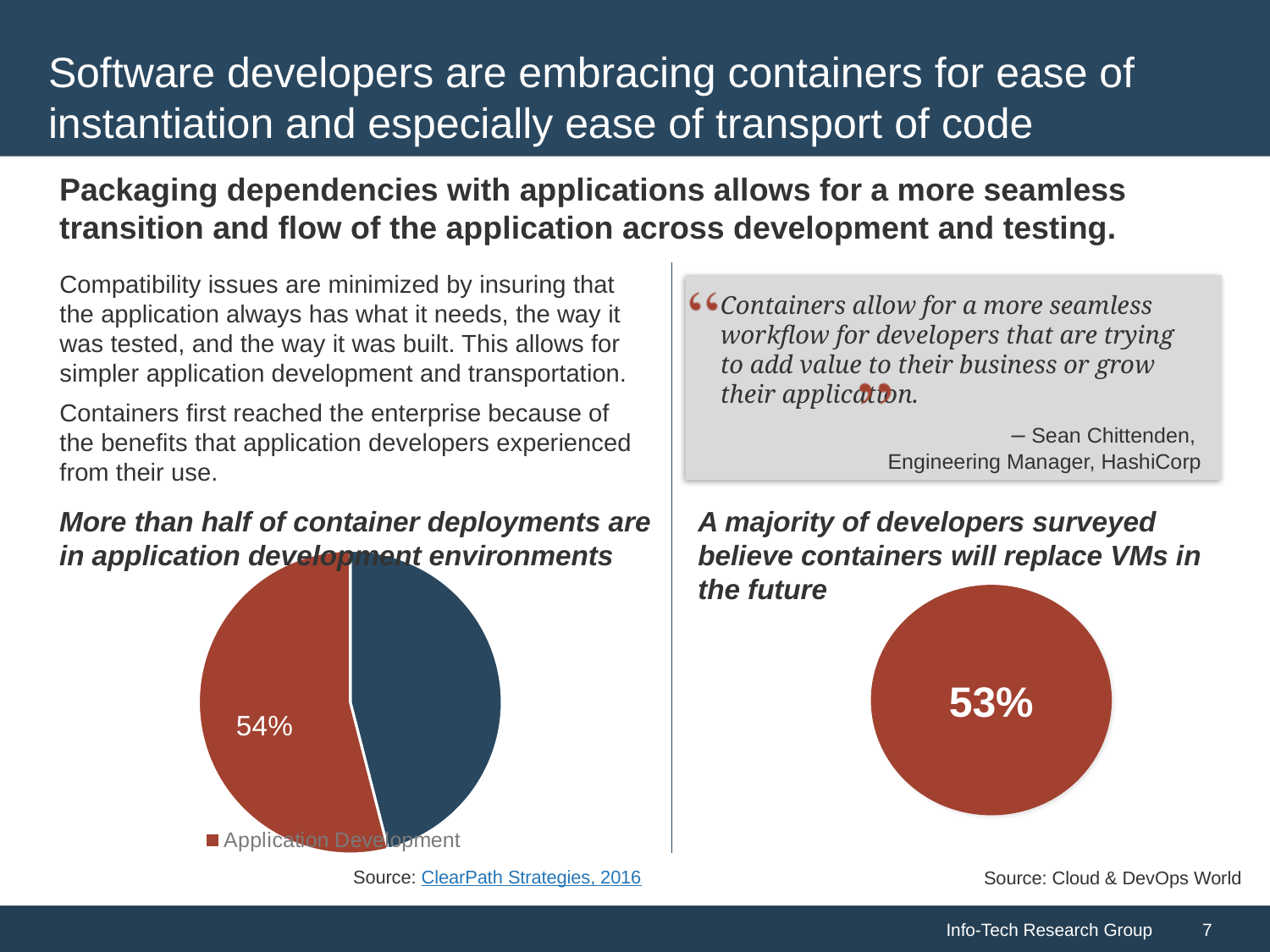
What kind of chart is shown on the left side of the slide under the heading about container deployments? pie chart What source is cited below the left pie chart? ClearPath Strategies, 2016 In the right-hand figure, what percentage of developers surveyed believe containers will replace VMs in the future? 53% How many slices does the left pie chart have? 2 What colour is the Application Development slice in the left pie chart? red In the left pie chart, which slice is larger, the red Application Development slice or the blue slice? Application Development In the left pie chart, what percentage is shown for Application Development? 54% How many entries does the legend of the left pie chart list? 1 In the left pie chart, which slice is the largest? Application Development In the left pie chart, what share of the pie does the Application Development slice represent? 54% In the left pie chart, is the value for Application Development greater or less than 50%? greater